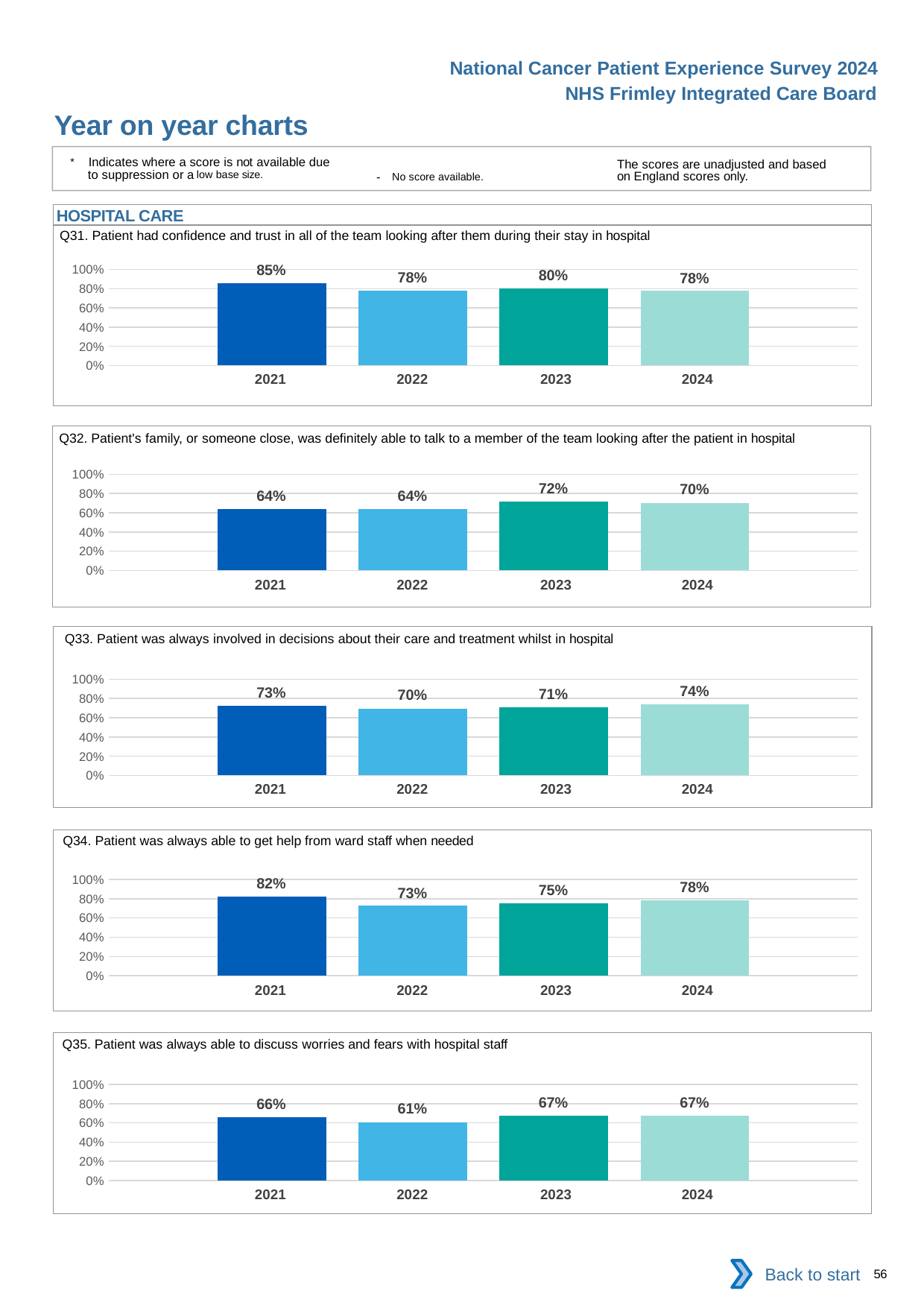
In the Q33 chart, what is the value for 2024? 74% In the Q32 chart, what is the value for 2023? 72% In the Q35 chart, what is the value for 2022? 61% In the Q34 chart, which is larger, the value for 2021 or the value for 2024? 2021 In the Q35 chart, how many years are shown on the x axis? 4 In the Q31 chart, what is the value for 2021? 85% In the Q32 chart, what is the difference between the 2023 and 2021 values? 8% In the Q34 chart, what is the difference between the 2021 and 2022 values? 9% What kind of chart is the Q34 chart? Bar chart In the Q31 chart, which year has the highest value? 2021 In the Q34 chart, do the values rise or fall from 2022 to 2024? Rise In the Q33 chart, which year has the lowest value? 2022